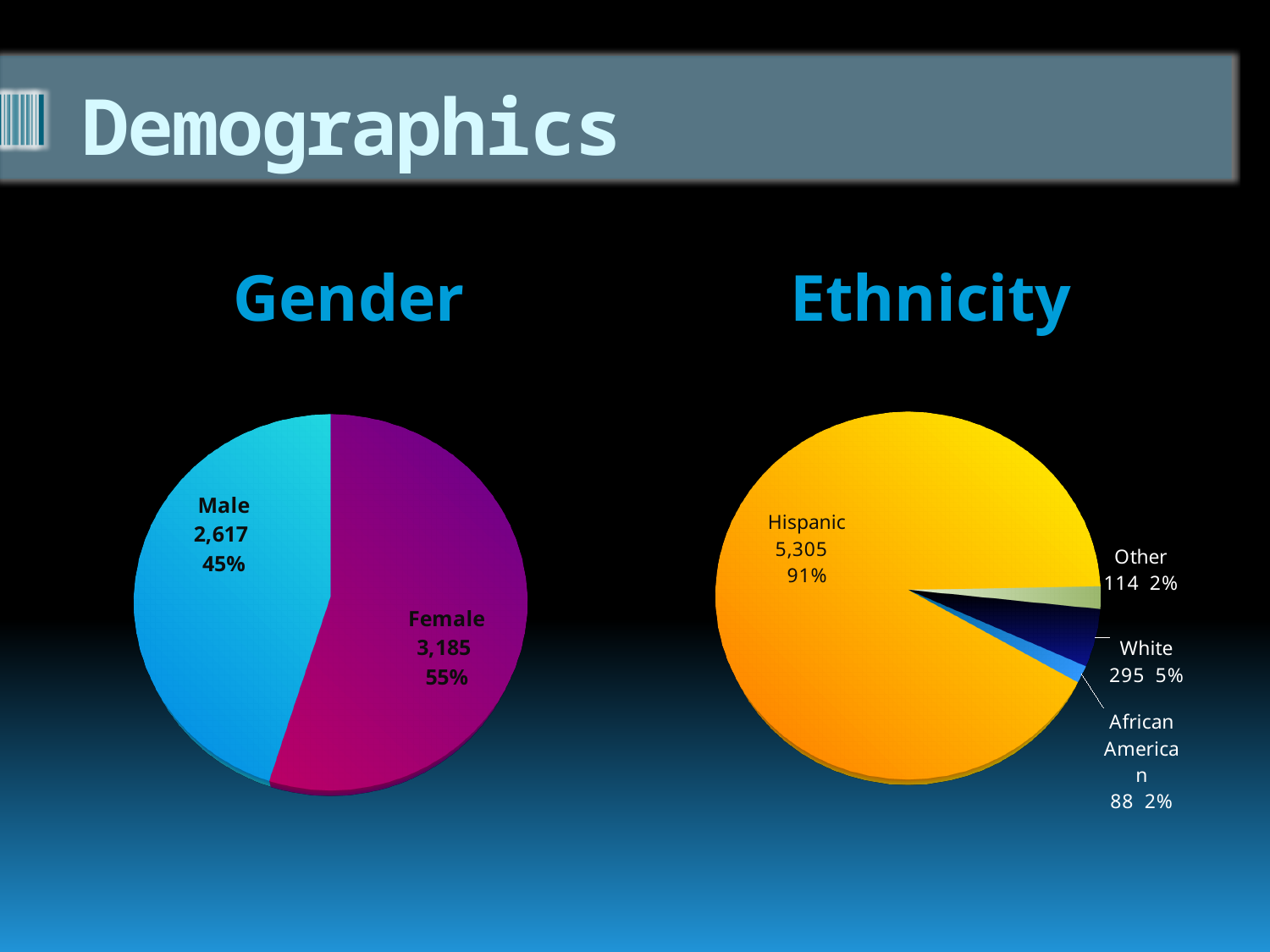
In the Ethnicity chart, how many categories are shown? 4 In the Gender chart, which category is larger, Male or Female? Female In the Gender chart, what colour is the Male slice? Blue In the Ethnicity chart, what is the value for Hispanic? 5,305 In the Ethnicity chart, what percentage share does Hispanic have? 91% In the Ethnicity chart, which category has the smallest value? African American In the Ethnicity chart, what is the value for White? 295 In the Gender chart, what percentage share does Male have? 45% In the Ethnicity chart, what is the difference between the White and Other values? 181 In the Gender chart, what is the value for Female? 3,185 What kind of chart is the Gender chart? Pie chart In the Gender chart, what is the difference between the Female and Male values? 568